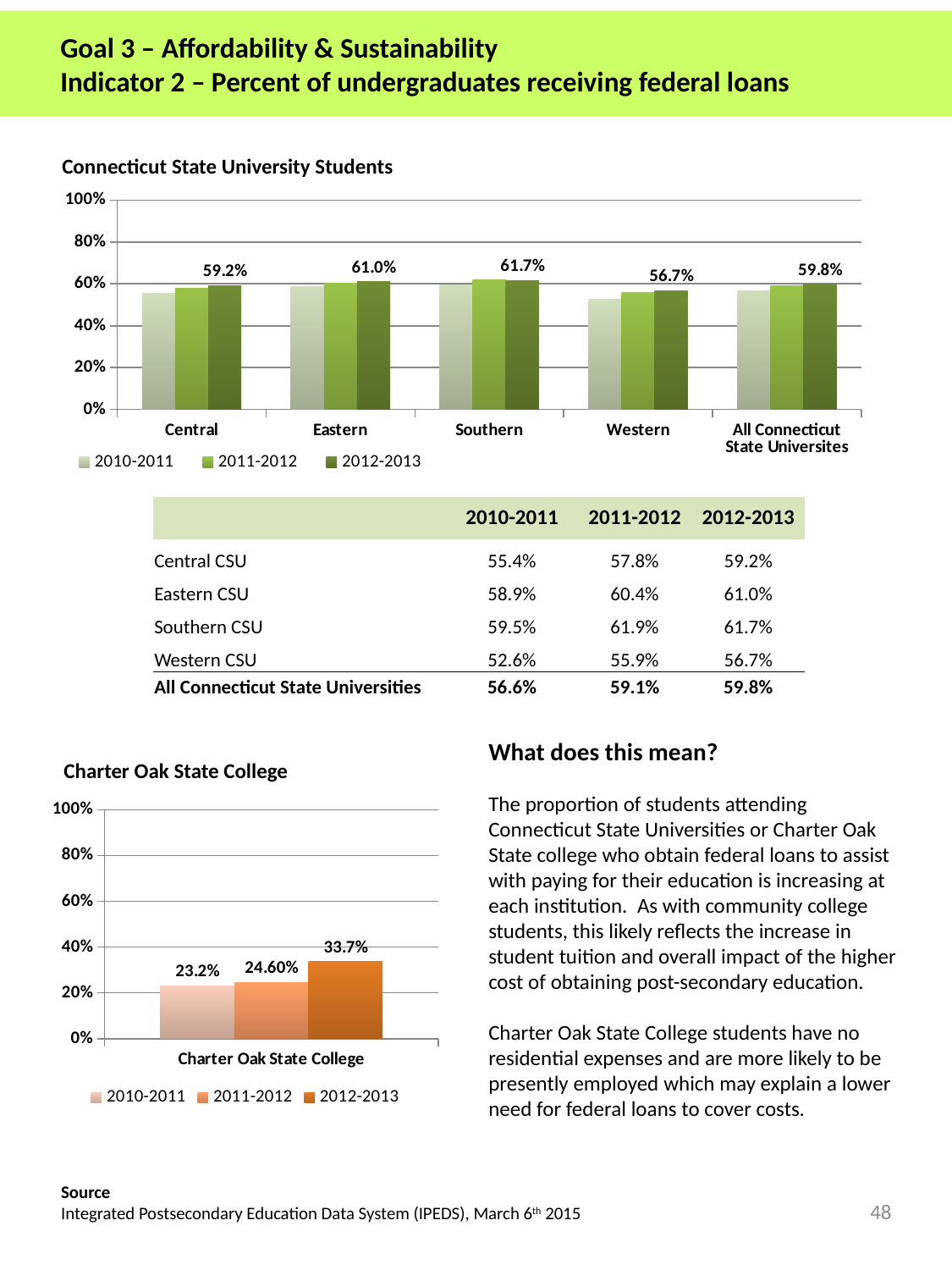
In the Connecticut State University Students chart, how many series does the legend list? 3 In the Connecticut State University Students chart, what is the difference between the 2012-2013 values for Eastern and Western? 4.3% In the Connecticut State University Students chart, which category has the lowest 2012-2013 value? Western In the Charter Oak State College chart, do the values rise or fall from 2010-2011 to 2012-2013? rise In the Connecticut State University Students chart, how many categories are shown on the x axis? 5 In the Charter Oak State College chart, what is the 2011-2012 value? 24.60% In the Connecticut State University Students chart, which category has the highest 2012-2013 value? Southern In the Connecticut State University Students chart, is the 2010-2011 value for Western greater or less than 60%? less In the Connecticut State University Students chart, what is the 2012-2013 value for Central? 59.2% In the Charter Oak State College chart, what is the 2012-2013 value? 33.7% What kind of chart is the Charter Oak State College chart? bar chart In the Connecticut State University Students chart, what is the 2012-2013 value for Western? 56.7%